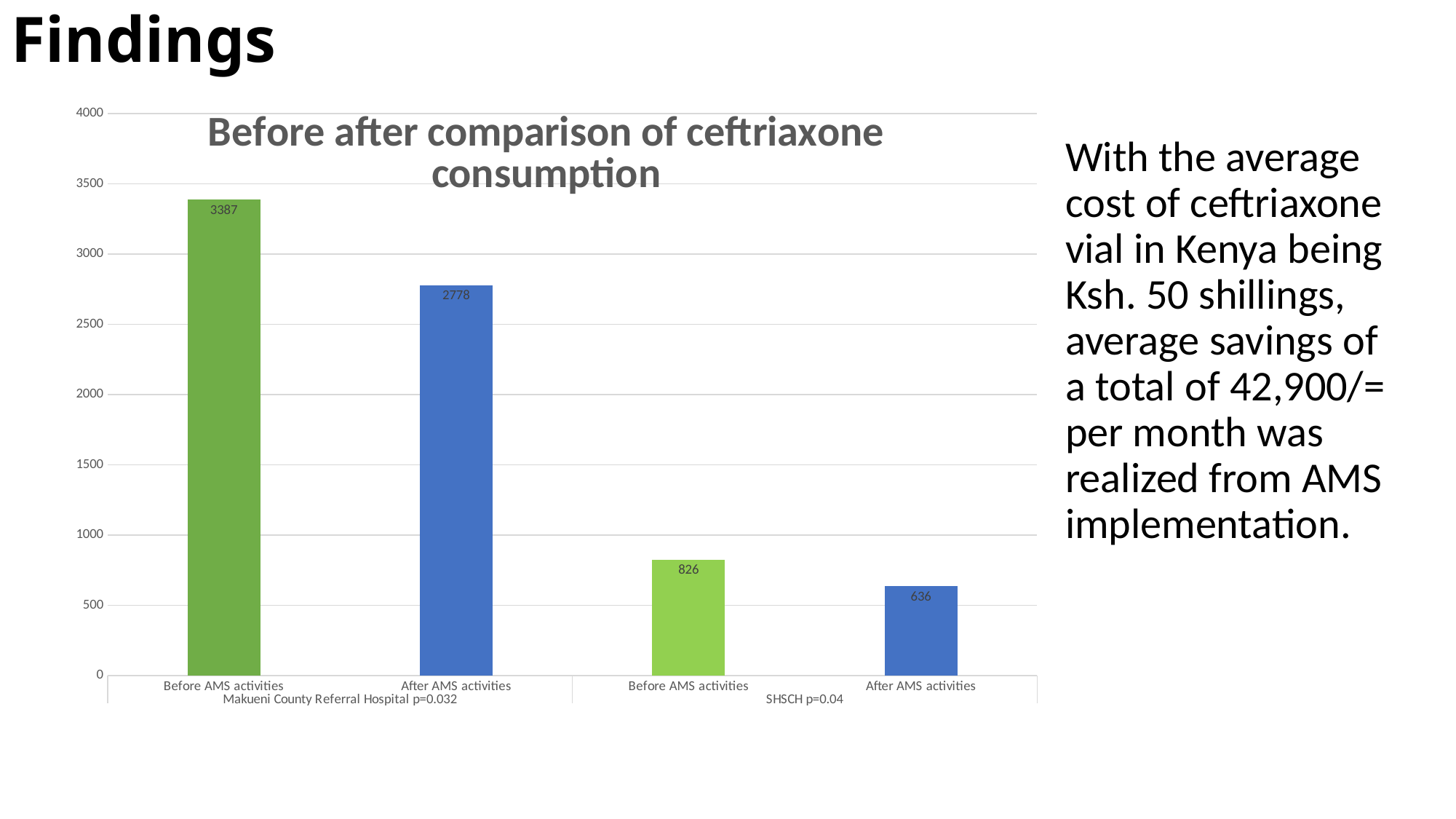
What is the difference between the Before and After AMS activities values at Makueni County Referral Hospital? 609 What is the ceftriaxone consumption value for After AMS activities at SHSCH? 636 What kind of chart is shown on the slide? Bar chart Which is larger: the After AMS activities value at Makueni County Referral Hospital or the Before AMS activities value at SHSCH? After AMS activities at Makueni County Referral Hospital What is the ceftriaxone consumption value for After AMS activities at Makueni County Referral Hospital? 2778 How many bars are plotted in the chart? 4 What is the ceftriaxone consumption value for Before AMS activities at SHSCH? 826 Which bar has the highest value in the chart? Before AMS activities, Makueni County Referral Hospital What is the difference between the Before and After AMS activities values at SHSCH? 190 What is the title of the chart? Before after comparison of ceftriaxone consumption Which bar has the lowest value in the chart? After AMS activities, SHSCH What is the ceftriaxone consumption value for Before AMS activities at Makueni County Referral Hospital? 3387